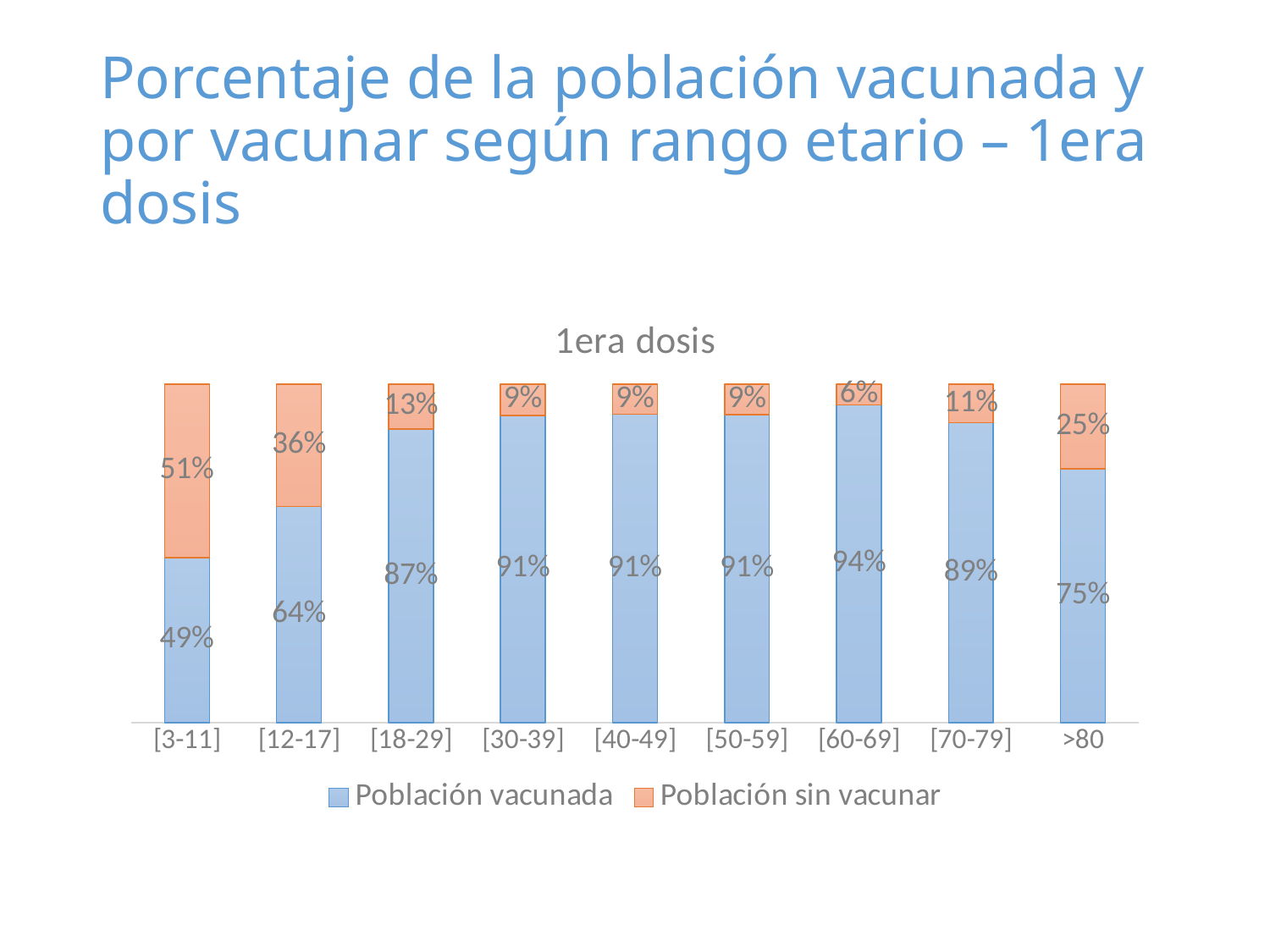
What is the title of the chart? 1era dosis What is the value of Población vacunada for the [70-79] age group? 89% What kind of chart is shown on the slide? Stacked bar chart What is the difference between the Población vacunada values for [12-17] and [3-11]? 15% Which age group has the lowest Población vacunada value? [3-11] How many age groups are shown on the x axis? 9 Which age group has the highest Población vacunada value? [60-69] Which is larger, the Población sin vacunar value for [18-29] or for [70-79]? [18-29] What is the value of Población vacunada for the [3-11] age group? 49% What is the total of the stacked bar for the [12-17] age group? 100% How many series does the legend list? 2 What is the value of Población sin vacunar for the >80 age group? 25%